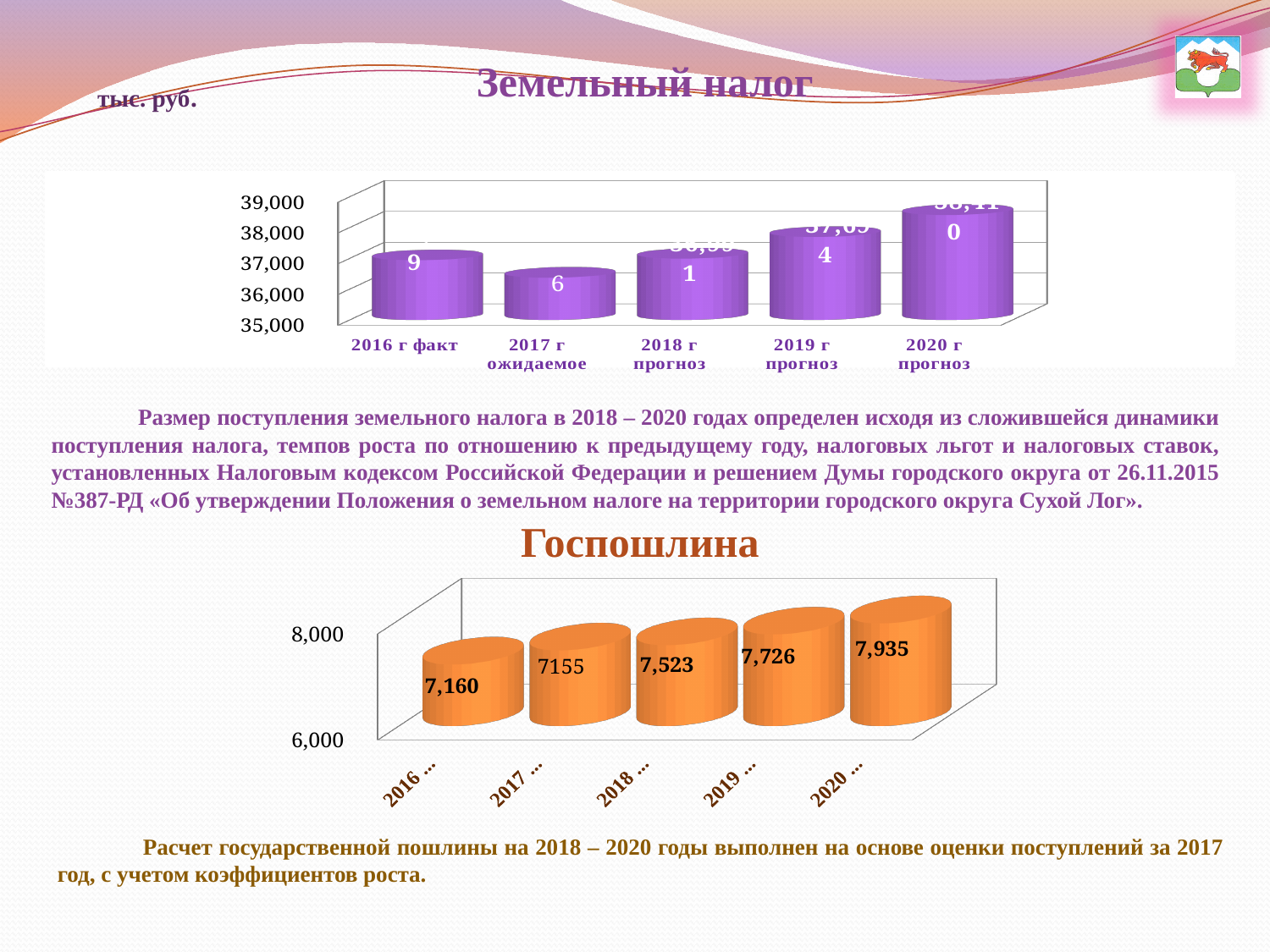
On the Земельный налог chart, is the value for 2017 г ожидаемое greater or less than 37,000? less On the Госпошлина chart, what is the difference between the 2020 value and the 2016 value? 775 On the Госпошлина chart, what is the value for 2016? 7,160 On the Госпошлина chart, what is the value for 2018? 7,523 On the Госпошлина chart, what is the value for 2019? 7,726 On the Земельный налог chart, which category has the highest value? 2020 г прогноз On the Земельный налог chart, is the value for 2020 г прогноз greater or less than 38,000? greater On the Госпошлина chart, which year has the highest value? 2020 On the Земельный налог chart, which category has the lowest value? 2017 г ожидаемое How many categories are shown on the Земельный налог chart? 5